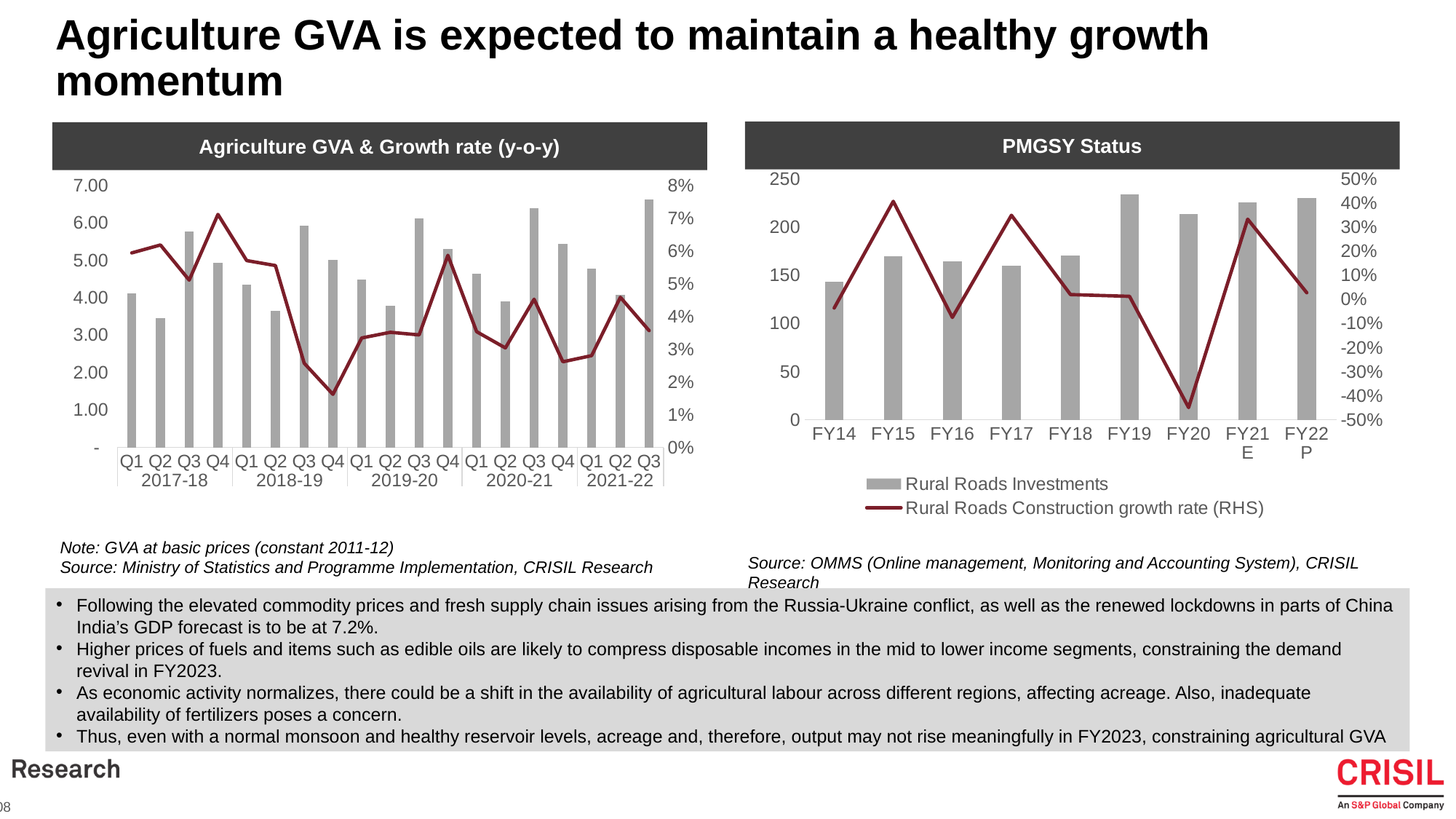
In the 'Agriculture GVA & Growth rate (y-o-y)' chart, which quarter has the lowest growth rate on the line? Q4 2018-19 What kind of chart is the 'PMGSY Status' chart? A combination bar and line chart In the 'PMGSY Status' chart, which is larger: the Rural Roads Investments bar for FY19 or for FY14? FY19 In the 'PMGSY Status' chart, which fiscal year has the lowest Rural Roads Construction growth rate? FY20 In the 'PMGSY Status' chart, which fiscal year has the lowest Rural Roads Investments bar? FY14 In the 'PMGSY Status' chart, is the Rural Roads Investments value for FY20 greater or less than 200? greater In the 'Agriculture GVA & Growth rate (y-o-y)' chart, which quarter has the highest GVA bar? Q3 2021-22 In the 'PMGSY Status' chart, is the Rural Roads Construction growth rate for FY20 greater or less than -40%? less In the 'Agriculture GVA & Growth rate (y-o-y)' chart, does the growth rate line rise or fall from Q1 2018-19 to Q4 2018-19? Fall How many fiscal years are shown on the x axis of the 'PMGSY Status' chart? 9 In the 'PMGSY Status' chart, which fiscal year has the highest Rural Roads Construction growth rate? FY15 How many series does the legend of the 'PMGSY Status' chart list? 2